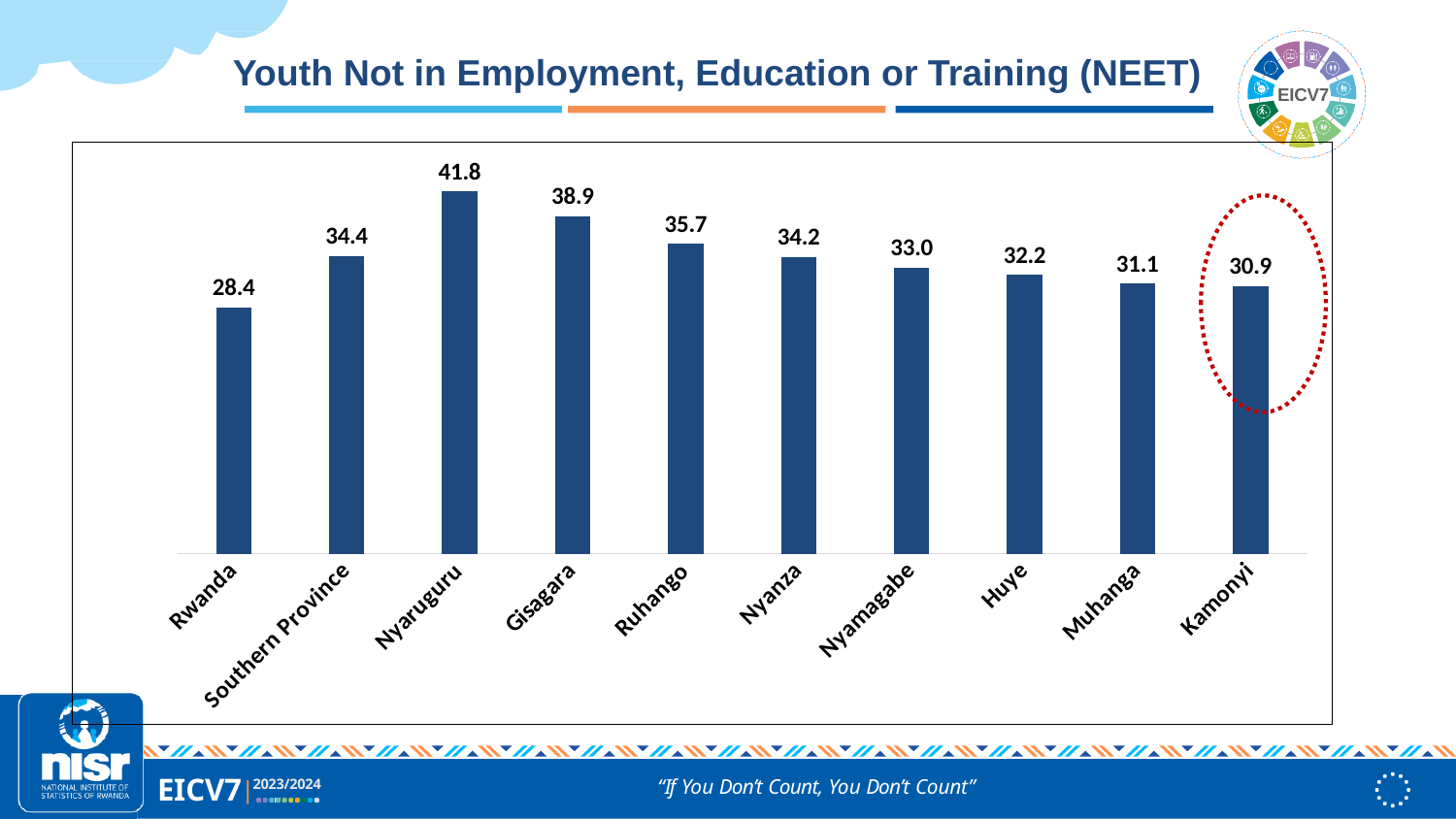
What is the NEET value for Southern Province? 34.4 What is the difference between the NEET values for Gisagara and Huye? 6.7 Which category has the lowest NEET value? Rwanda Which has a higher NEET value, Ruhango or Nyanza? Ruhango Which category has the highest NEET value? Nyaruguru What kind of chart is shown on the slide? Bar chart What is the NEET value for Kamonyi? 30.9 What is the NEET value for Nyaruguru? 41.8 How many categories are shown on the x axis? 10 Which category's bar is circled with a red dotted outline? Kamonyi What is the difference between the NEET values for Nyaruguru and Rwanda? 13.4 What is the NEET value for Rwanda? 28.4